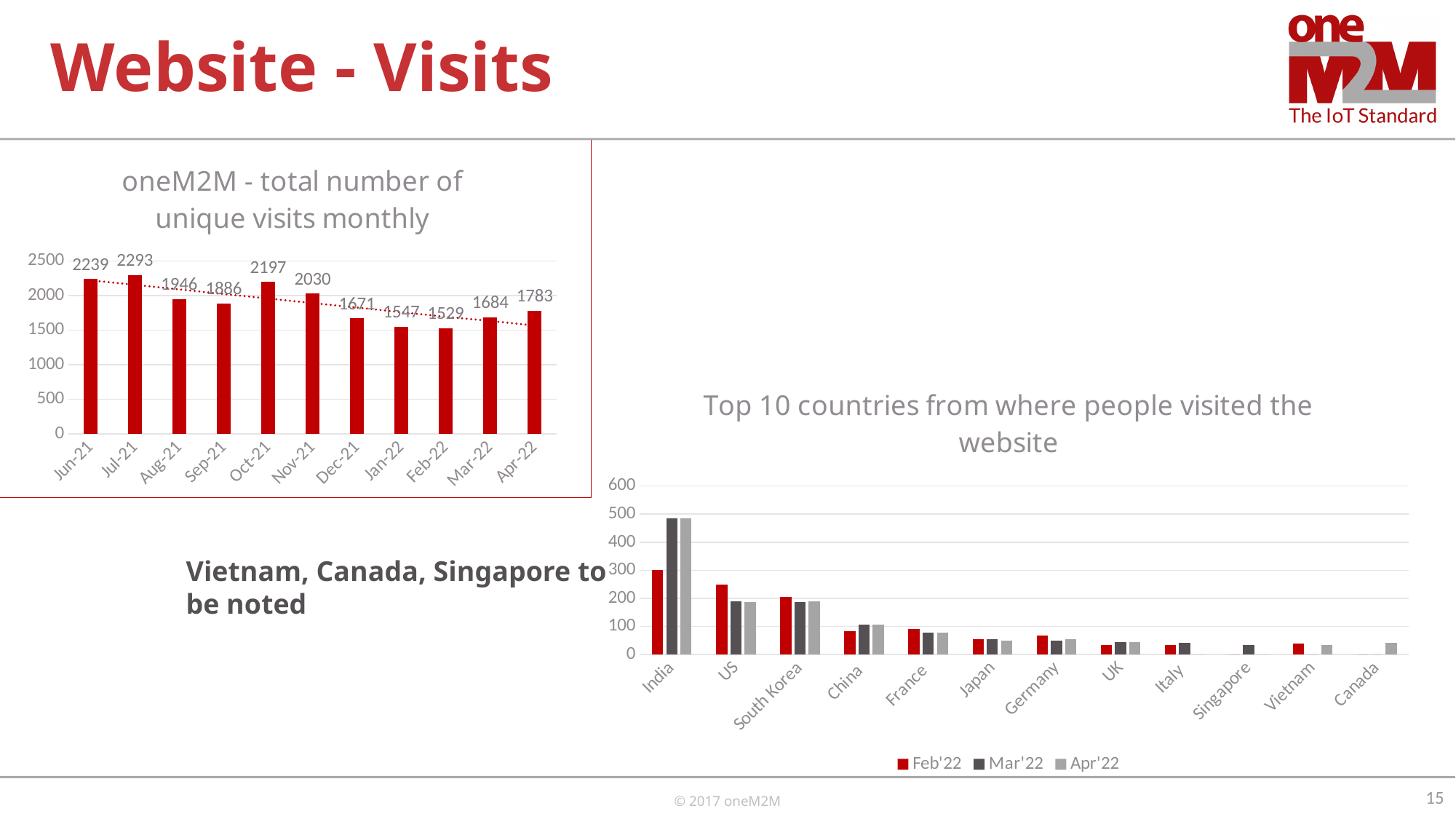
In the chart 'oneM2M - total number of unique visits monthly', which month had the lowest number of unique visits? Feb-22 In the chart 'oneM2M - total number of unique visits monthly', what was the number of unique visits in Apr-22? 1783 In the chart 'Top 10 countries from where people visited the website', which country has the highest Feb'22 value? India In the chart 'oneM2M - total number of unique visits monthly', how many months are plotted? 11 In the chart 'Top 10 countries from where people visited the website', how many series does the legend list? 3 In the chart 'Top 10 countries from where people visited the website', how many countries are shown on the x axis? 12 In the chart 'Top 10 countries from where people visited the website', which is larger for India: the Feb'22 value or the Mar'22 value? Mar'22 In the chart 'oneM2M - total number of unique visits monthly', which month had the highest number of unique visits? Jul-21 In the chart 'Top 10 countries from where people visited the website', is the Mar'22 value for India greater or less than 400? greater In the chart 'oneM2M - total number of unique visits monthly', what type of chart is used? Bar chart In the chart 'oneM2M - total number of unique visits monthly', what was the number of unique visits in Oct-21? 2197 In the chart 'oneM2M - total number of unique visits monthly', what is the difference between the Jul-21 and Jun-21 values? 54